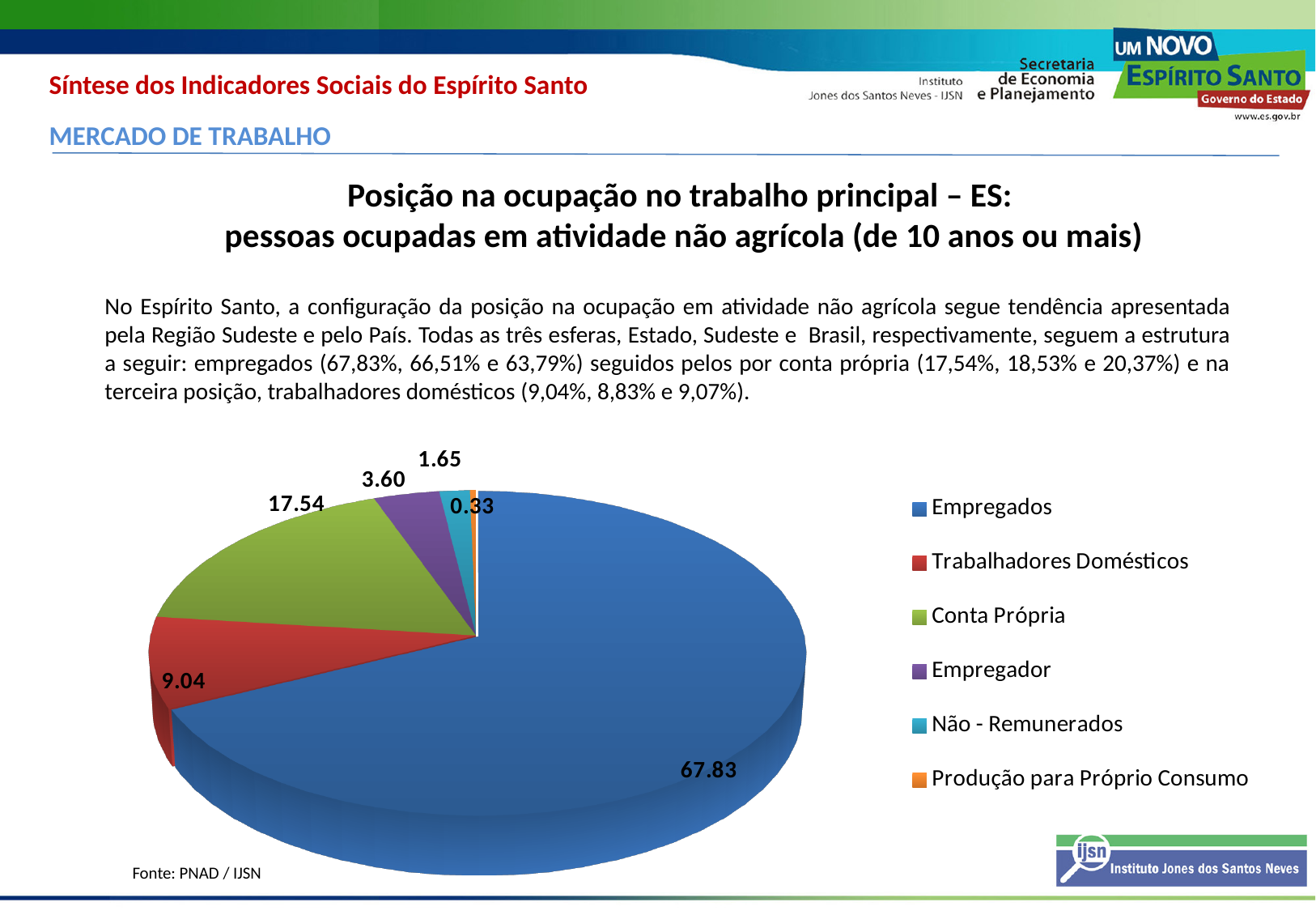
Which is larger, the value for Empregador or the value for Não - Remunerados? Empregador What colour is the Conta Própria slice in the pie chart? Green Which category has the largest slice of the pie chart? Empregados What is the value for Conta Própria in the pie chart? 17.54 What is the value for Produção para Próprio Consumo in the pie chart? 0.33 What is the value for Empregados in the pie chart? 67.83 How many categories does the legend of the pie chart list? 6 What kind of chart is shown on the slide? Pie chart What is the value for Trabalhadores Domésticos in the pie chart? 9.04 What is the value for Empregador in the pie chart? 3.60 Which category has the smallest slice of the pie chart? Produção para Próprio Consumo What is the difference between the values for Conta Própria and Trabalhadores Domésticos? 8.50